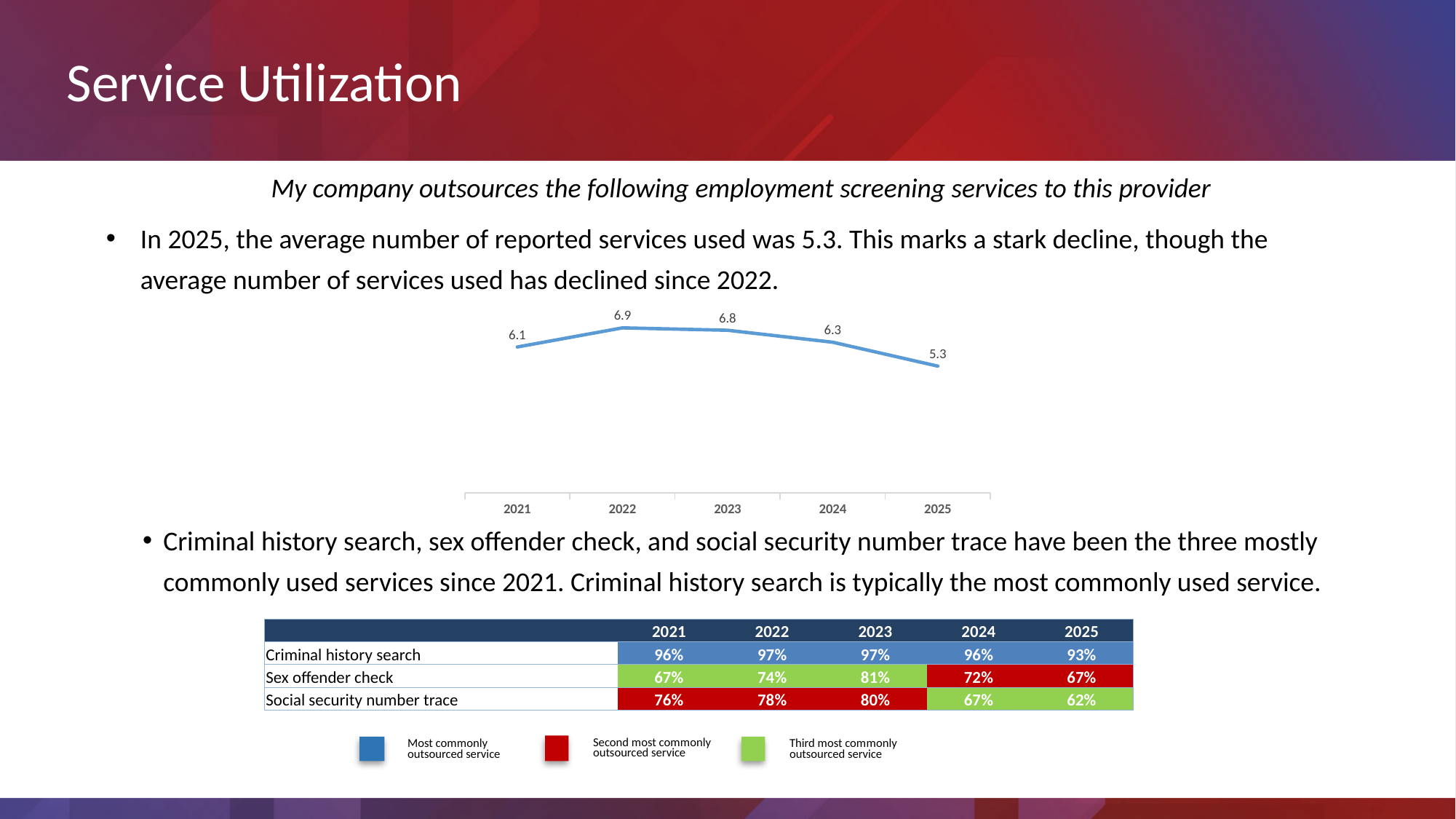
What is the first year shown on the x axis of the line chart? 2021 How many data points are plotted in the line chart? 5 In the line chart, what is the difference between the values for 2022 and 2025? 1.6 In the line chart, what is the value for 2023? 6.8 What type of chart is shown on the slide? line chart In the line chart, what is the value for 2021? 6.1 In the line chart, what is the value for 2025? 5.3 In the line chart, which year has the highest value? 2022 In the line chart, which year has the lowest value? 2025 In the line chart, which is larger, the value for 2021 or the value for 2024? 2024 In the line chart, what is the difference between the values for 2021 and 2024? 0.2 In the line chart, do the values rise or fall from 2022 to 2025? fall